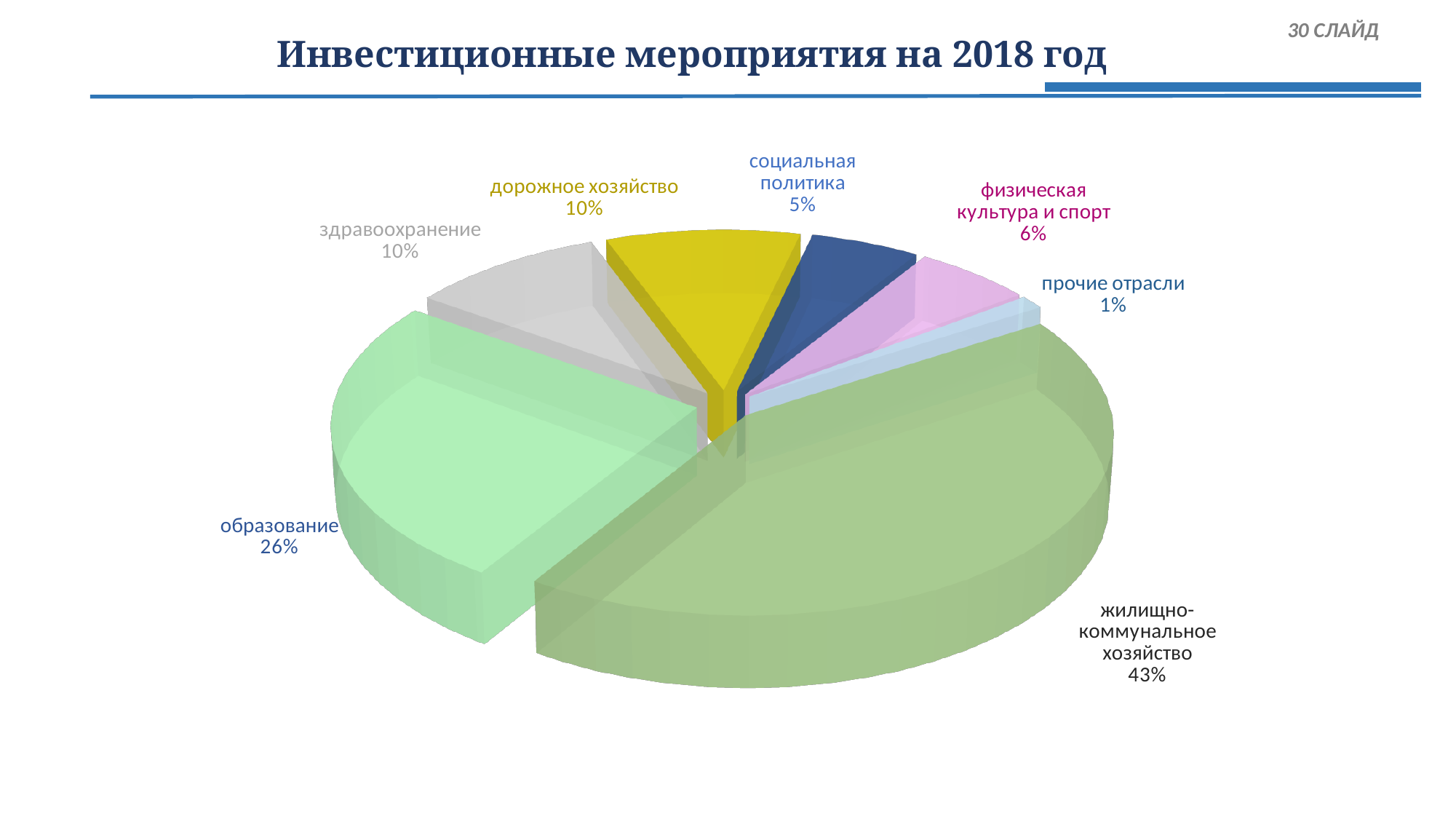
What share of the pie does "жилищно-коммунальное хозяйство" have? 43% What is the value shown for "социальная политика"? 5% What is the difference in percentage points between "жилищно-коммунальное хозяйство" and "образование"? 17 Which category has the largest slice of the pie? жилищно-коммунальное хозяйство What is the value shown for "дорожное хозяйство"? 10% How many categories (slices) does the pie chart have? 7 What is the value shown for "физическая культура и спорт"? 6% What share of the pie does "образование" have? 26% Which is larger, the share for "физическая культура и спорт" or the share for "социальная политика"? физическая культура и спорт Which category has the smallest slice of the pie? прочие отрасли What is the title of the slide containing the chart? Инвестиционные мероприятия на 2018 год What type of chart is shown on the slide? pie chart